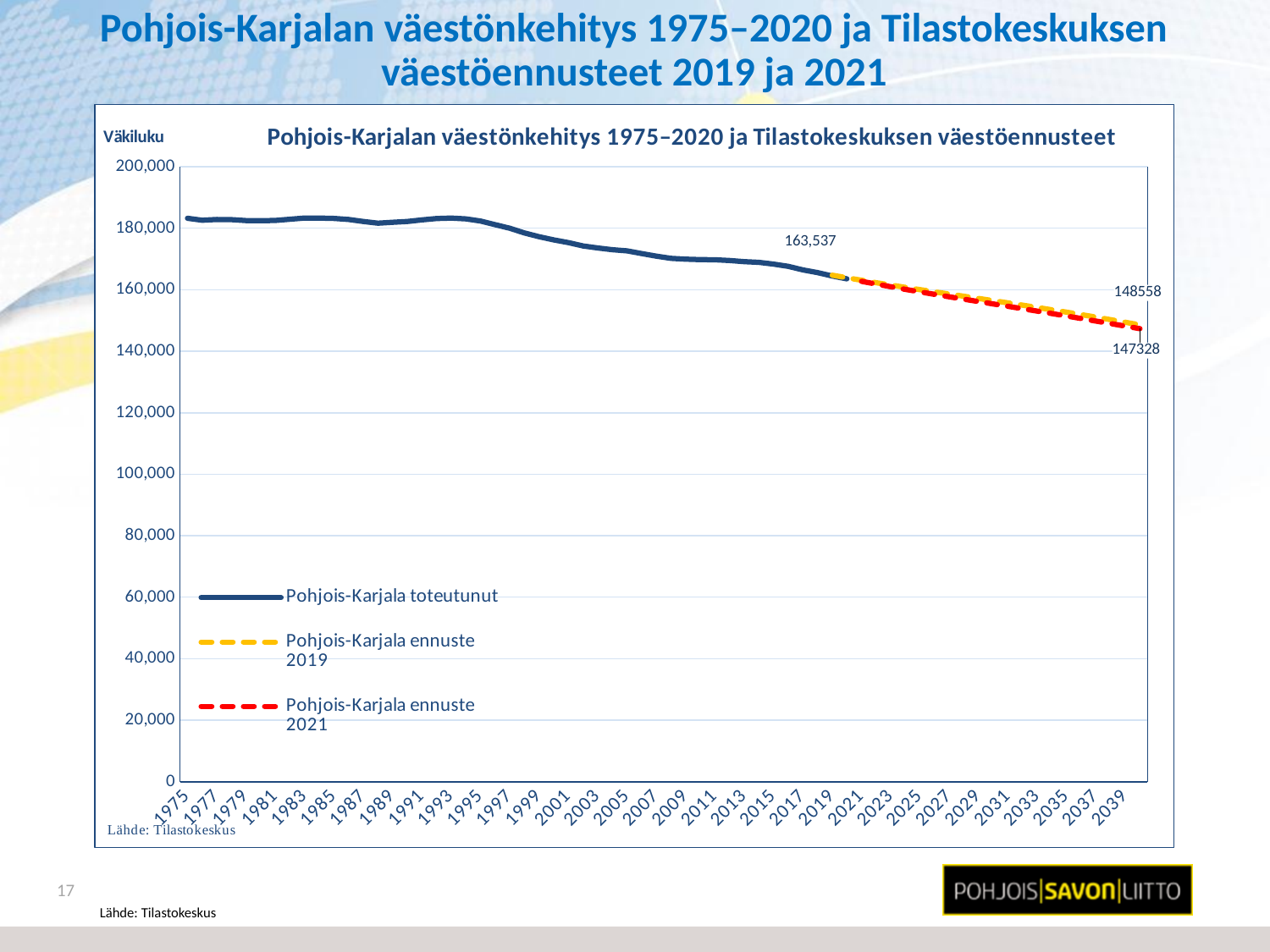
Is the value for Pohjois-Karjala toteutunut in 1975 greater or less than 180,000? greater What is the labelled end value of the Pohjois-Karjala ennuste 2021 series? 147328 What label is shown on the vertical axis of the chart? Väkiluku Does the Pohjois-Karjala toteutunut series rise or fall between 1995 and 2020? fall What is the labelled value at the end of the Pohjois-Karjala toteutunut series? 163,537 Which forecast series ends at a higher value, ennuste 2019 or ennuste 2021? Pohjois-Karjala ennuste 2019 What is the labelled end value of the Pohjois-Karjala ennuste 2019 series? 148558 What type of chart is shown on the slide? line chart Is the value for Pohjois-Karjala toteutunut in 2009 greater or less than 180,000? less What is the difference between the labelled end values of the ennuste 2019 and ennuste 2021 series? 1230 How many series does the legend list? 3 What is the difference between the labelled value 163,537 and the ennuste 2021 end value 147328? 16209